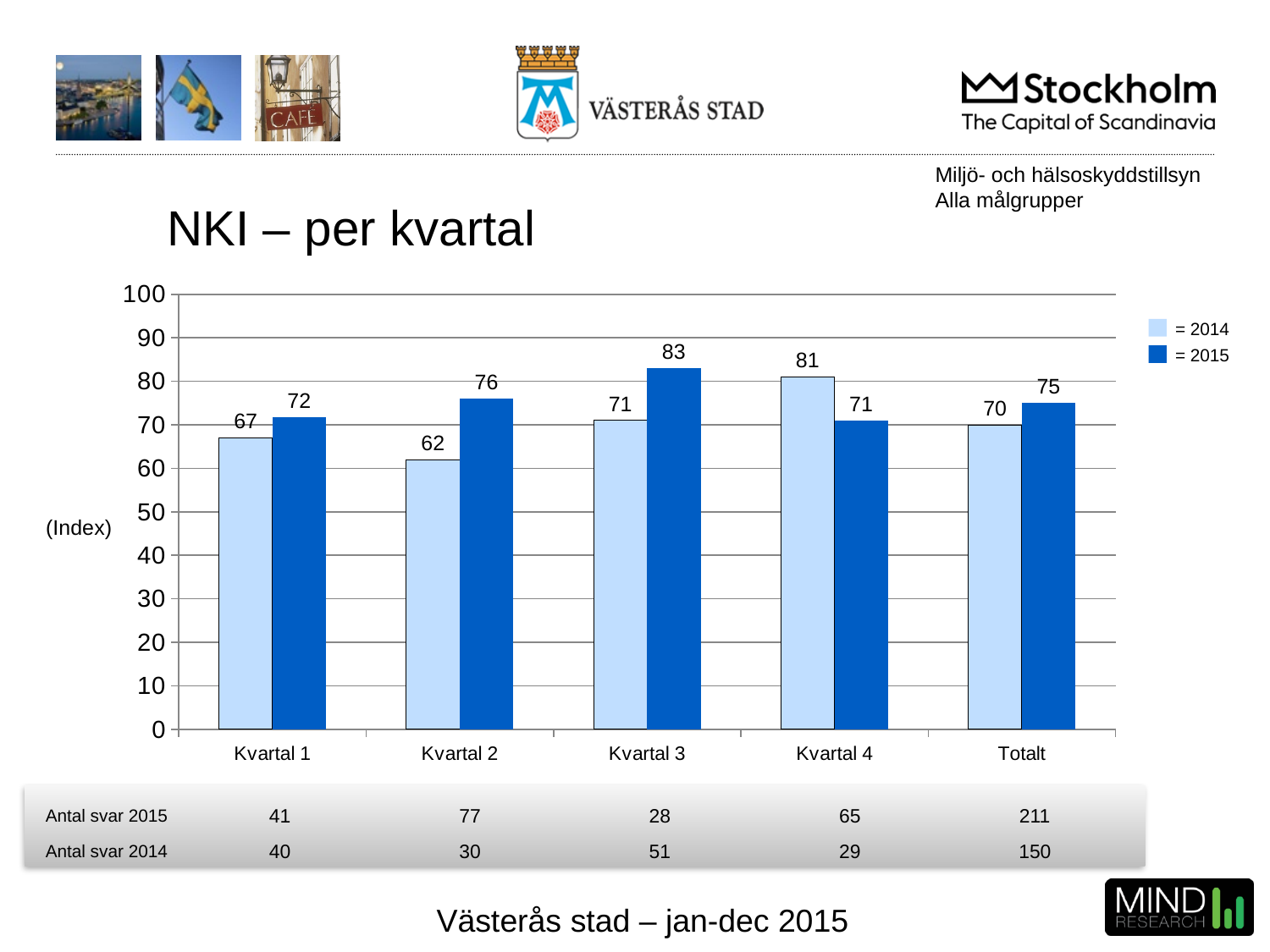
Is the 2015 value for Kvartal 3 greater or less than 80? greater What is the title of the chart? NKI – per kvartal What is the 2015 NKI value for Kvartal 3? 83 What is the 2014 NKI value for Kvartal 2? 62 What kind of chart is shown on the slide? bar chart What is the difference between the 2015 and 2014 values for Kvartal 2? 14 How many categories are shown on the x axis? 5 Which quarter has the lowest 2014 value? Kvartal 2 Which is larger for Kvartal 4, the 2014 value or the 2015 value? 2014 How many series does the legend list? 2 Which quarter has the highest 2014 value? Kvartal 4 What is the 2015 value for Totalt? 75